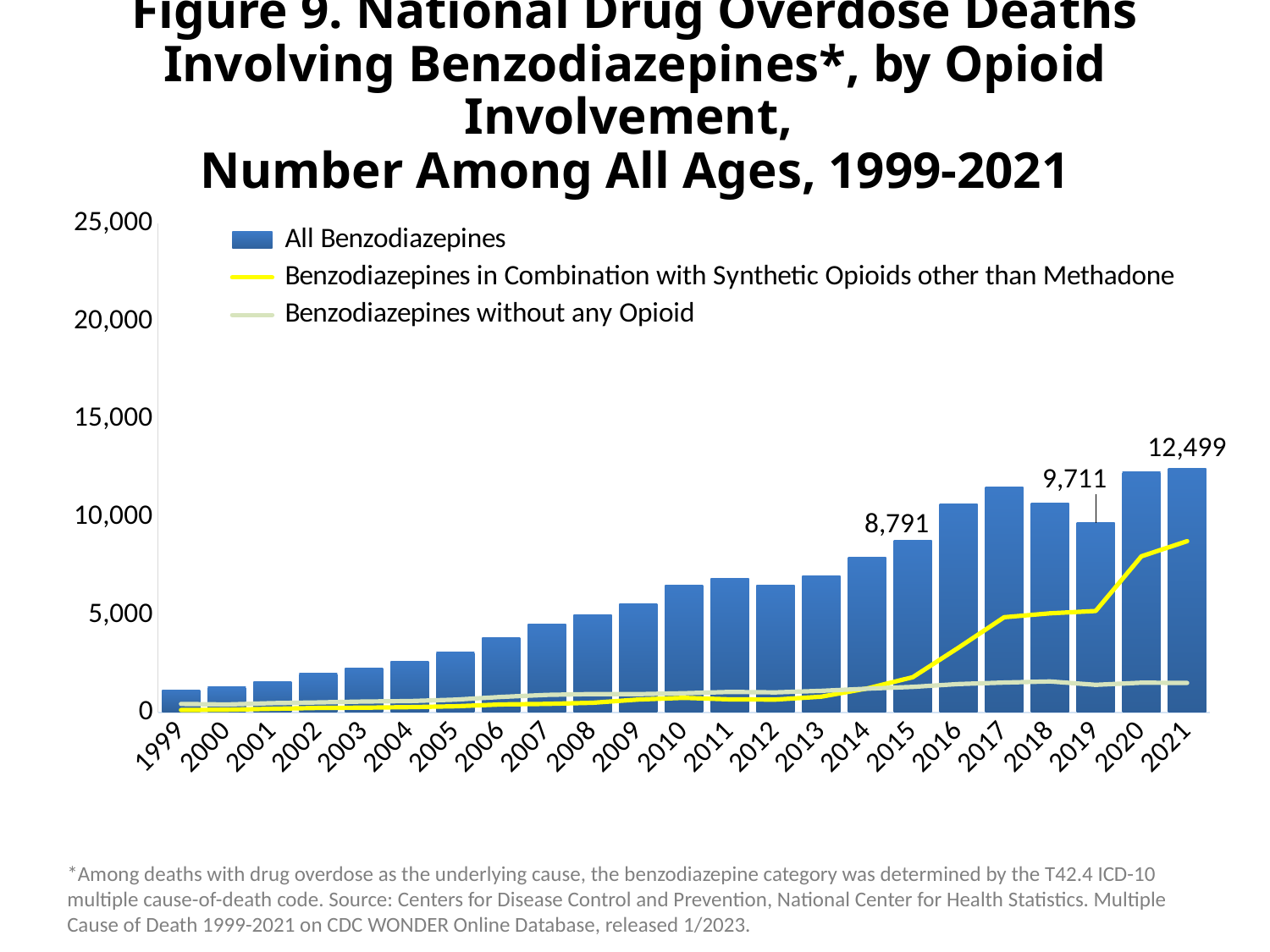
What is the difference between the All Benzodiazepines values for 2021 and 2015? 3,708 What is the difference between the All Benzodiazepines values for 2021 and 2019? 2,788 How many years are shown on the x axis? 23 Which year has the highest number of All Benzodiazepines deaths? 2021 Is the All Benzodiazepines value for 2005 greater or less than 5,000? less How many series does the legend list? 3 What is the value for All Benzodiazepines in 2019? 9,711 Is the All Benzodiazepines value for 2010 greater or less than 5,000? greater Which year has a larger All Benzodiazepines value, 2019 or 2020? 2020 What is the value for All Benzodiazepines in 2015? 8,791 What is the value for All Benzodiazepines in 2021? 12,499 Which year has the lowest number of All Benzodiazepines deaths? 1999